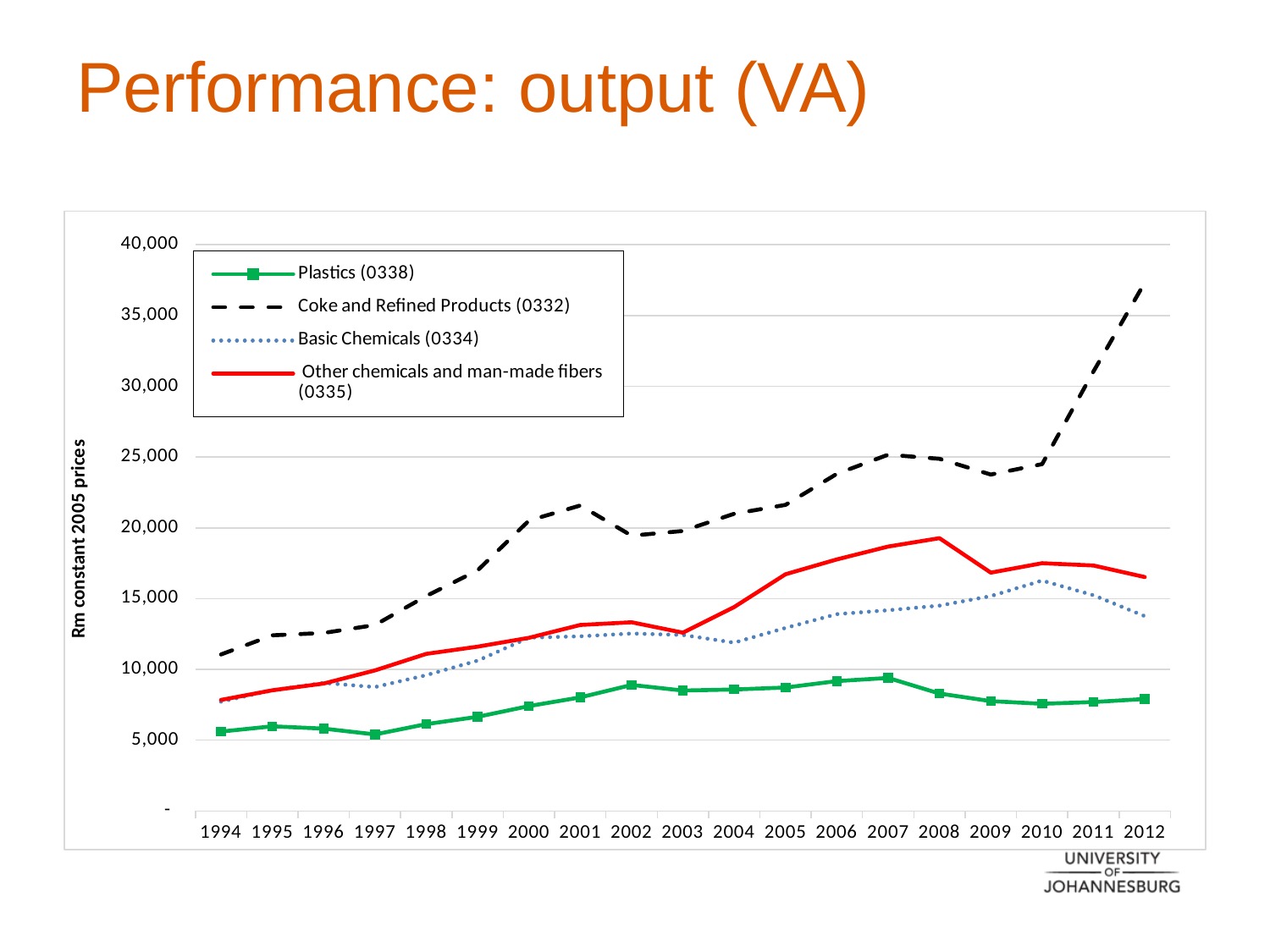
Which series has the highest value in 2012? Coke and Refined Products (0332) In 2010, which is larger: Basic Chemicals (0334) or Plastics (0338)? Basic Chemicals (0334) Is the value for Coke and Refined Products (0332) in 2012 greater or less than 35,000? greater In 2007, which is larger: Other chemicals and man-made fibers (0335) or Basic Chemicals (0334)? Other chemicals and man-made fibers (0335) Does the Coke and Refined Products (0332) line rise or fall from 2010 to 2012? rise How many series does the legend list? 4 How many years are shown on the x axis? 19 What is the label on the y axis? Rm constant 2005 prices Which series has the lowest value in 2012? Plastics (0338) Is the value for Other chemicals and man-made fibers (0335) in 2008 greater or less than 15,000? greater What kind of chart is shown on the slide? line chart Is the value for Plastics (0338) in 1997 greater or less than 10,000? less